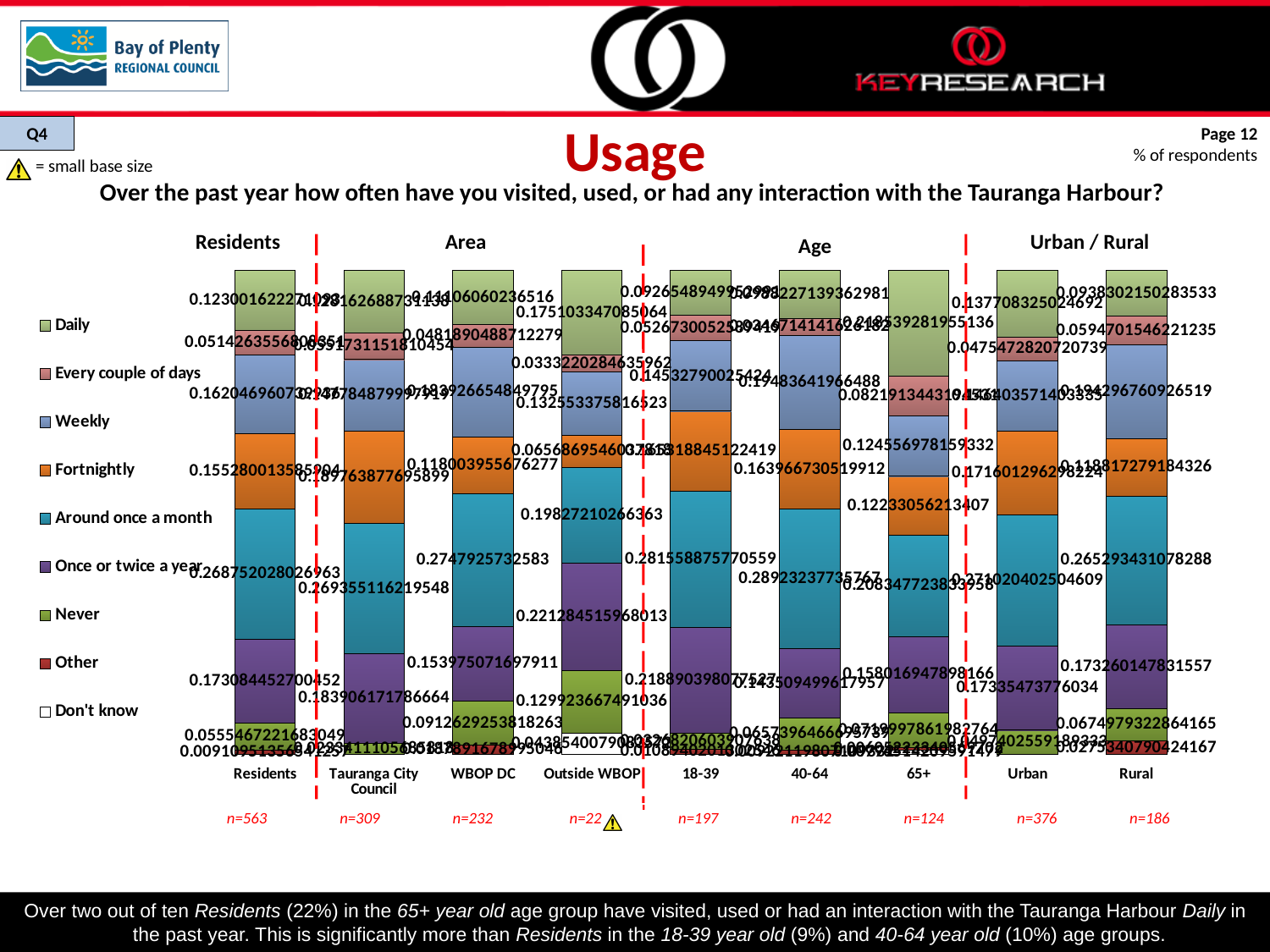
Which group on the x axis is flagged with the small base size warning? Outside WBOP What kind of chart is shown on the slide? bar chart According to the slide, what percentage of residents in the 65+ age group visited the Tauranga Harbour Daily? 22% How many series does the chart's legend list? 9 What is the title of the chart on the slide? Usage Which age group has the larger Daily segment, 65+ or 18-39? 65+ How many groups (bars) are plotted along the x axis of the chart? 9